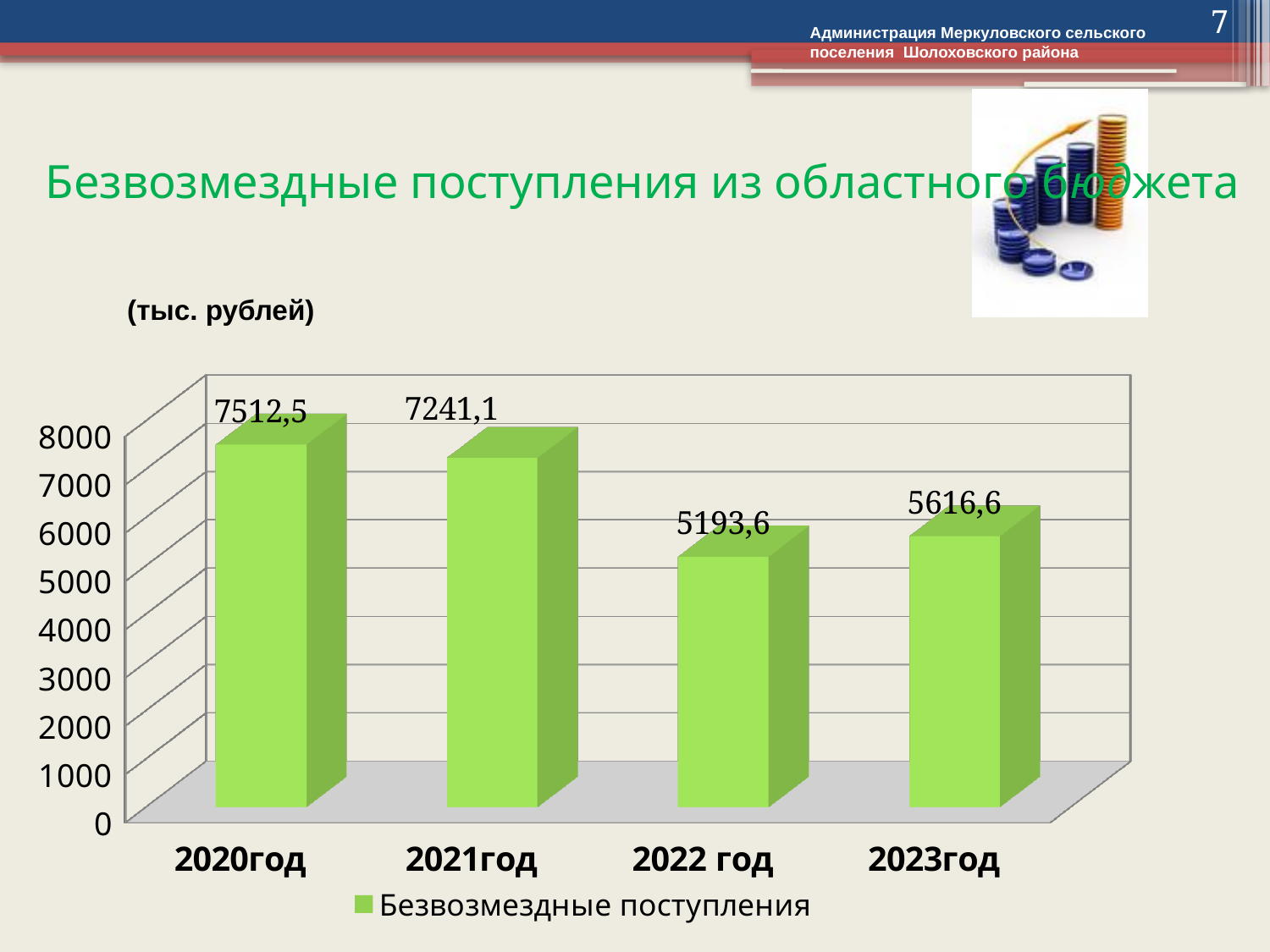
What is the value for 2023год? 5616,6 Which year has the highest value? 2020год What is the difference between the values for 2023год and 2022 год? 423 Do the values rise or fall from 2020год to 2022 год? fall Which is larger, the value for 2021год or the value for 2023год? 2021год What kind of chart is shown on the slide? bar chart Which year has the lowest value? 2022 год What is the value for 2022 год? 5193,6 What is the value for 2020год? 7512,5 What is the value for 2021год? 7241,1 How many years are shown on the chart? 4 What is the difference between the values for 2020год and 2021год? 271,4